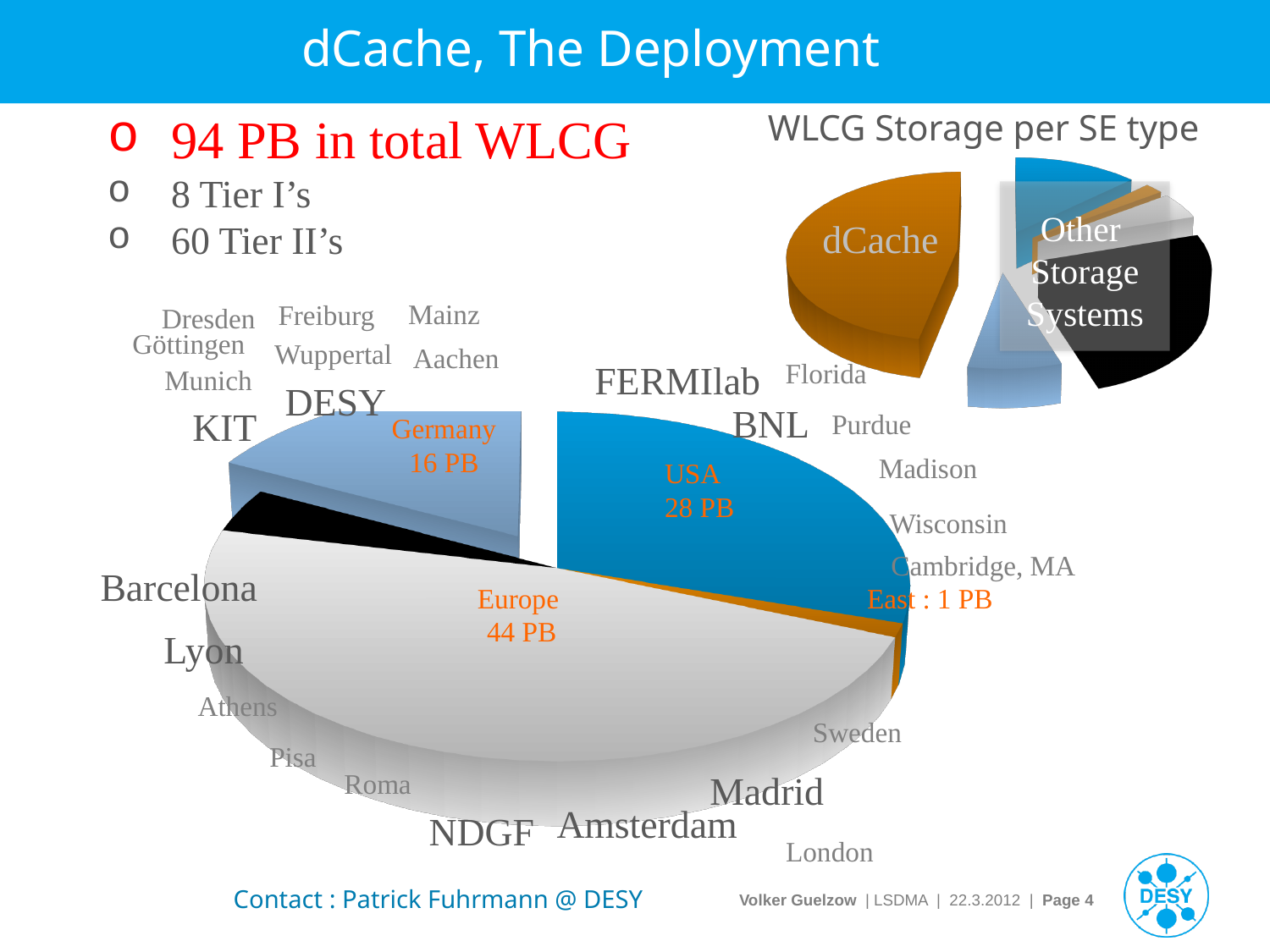
In the large pie chart, what value is shown for Europe? 44 PB In the large pie chart, what value is shown for East? 1 PB In the large pie chart, what value is shown for USA? 28 PB What are the two categories labeled in the pie chart titled 'WLCG Storage per SE type'? dCache and Other Storage Systems In the large pie chart, what is the difference between the Europe and USA values? 16 PB In the large pie chart, which labeled region has the largest value? Europe How many labeled regions with values are shown in the large pie chart? 4 In the large pie chart, which is larger, the value for USA or the value for Germany? USA In the large pie chart, which labeled region has the smallest value? East What kind of chart is the chart titled 'WLCG Storage per SE type'? Pie chart In the large pie chart, what is the difference between the USA and Germany values? 12 PB In the large pie chart, what value is shown for Germany? 16 PB